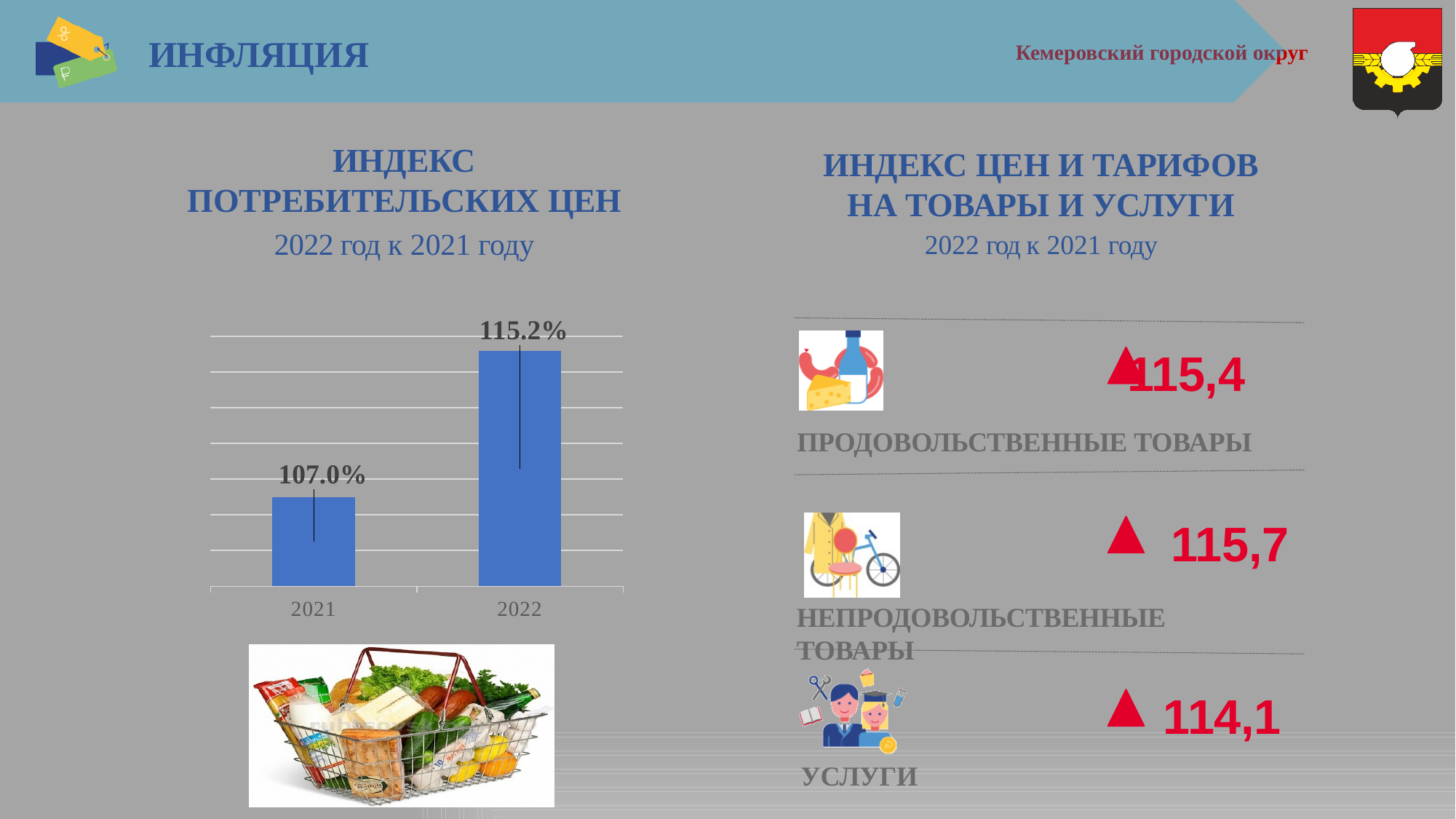
What type of chart is shown on the left of the slide? bar chart What colour are the bars in the bar chart? blue Is the value for 2022 larger or smaller than the value for 2021 in the bar chart? larger What is the title of the bar chart on the slide? ИНДЕКС ПОТРЕБИТЕЛЬСКИХ ЦЕН How many bars are plotted in the bar chart? 2 What is the value shown for 2021 in the bar chart? 107.0% Which year has the higher value in the bar chart? 2022 Do the values in the bar chart rise or fall from 2021 to 2022? rise Which year has the lower value in the bar chart? 2021 By how many percentage points does the 2022 value exceed the 2021 value in the bar chart? 8.2 What is the value shown for 2022 in the bar chart? 115.2%